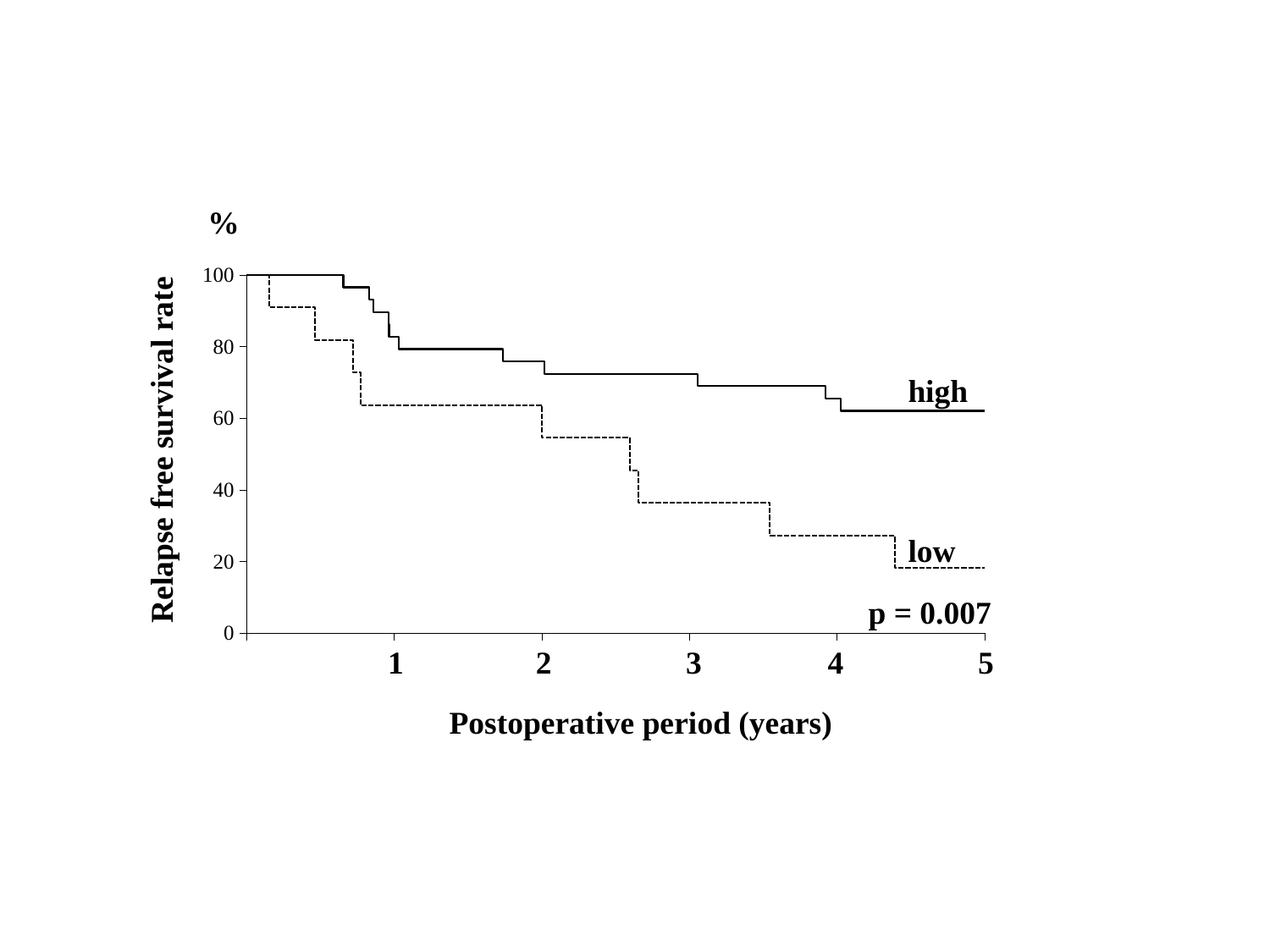
Do the relapse free survival rates rise or fall as the postoperative period increases? fall Is the relapse free survival rate for the high group at 2 years greater or less than 60? greater Is the relapse free survival rate for the low group at 3 years greater or less than 60? less At 4 years, which group has the lower relapse free survival rate, high or low? low Is the relapse free survival rate for the low group at 4 years greater or less than 40? less What p value is shown on the chart? p = 0.007 At 3 years, which group has the higher relapse free survival rate, high or low? high What kind of chart is shown on the slide? line chart What is the label of the x axis? Postoperative period (years) How many series (curves) are plotted on the chart? 2